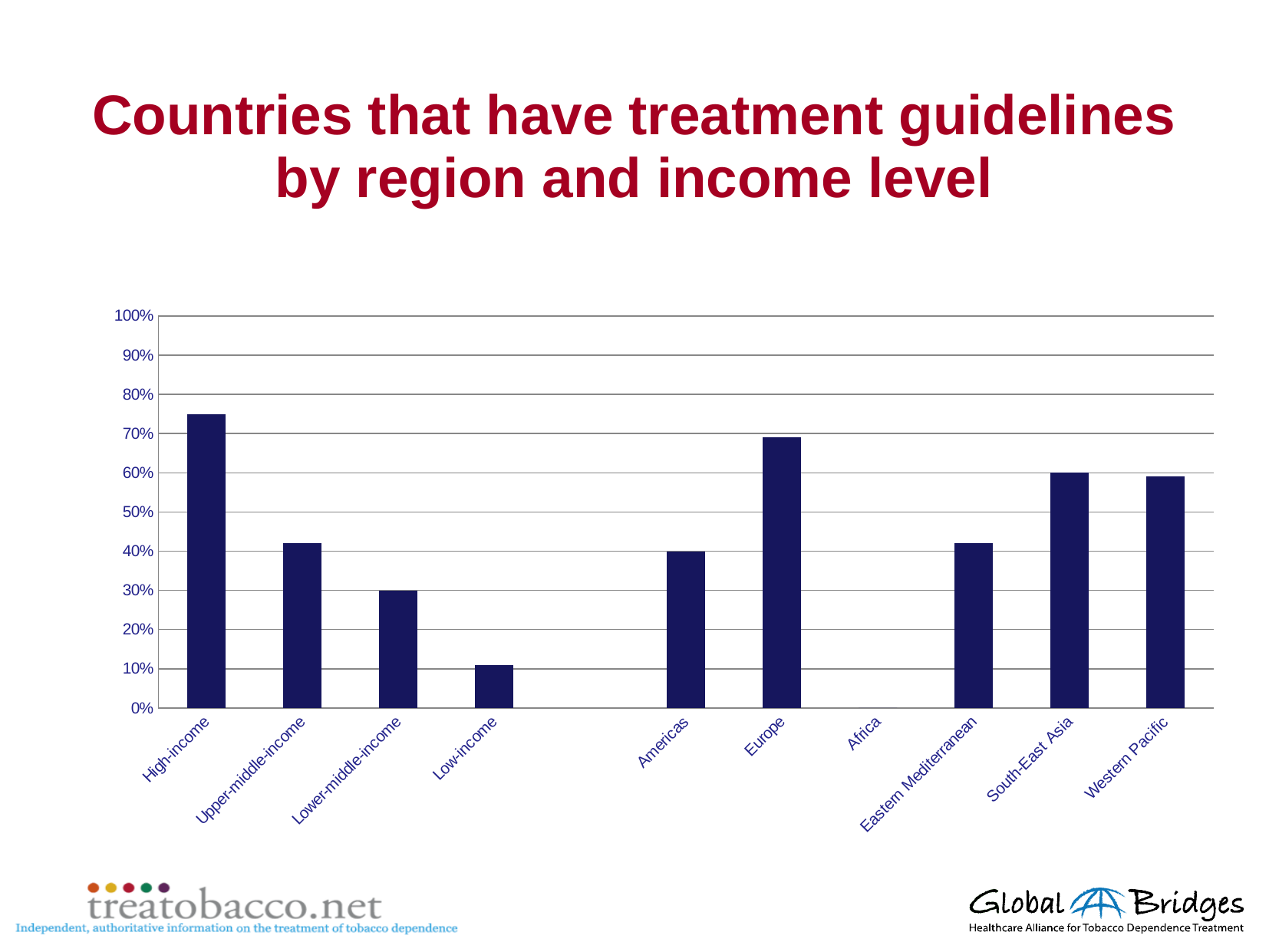
Which category has the lowest value? Africa What kind of chart is shown on the slide? bar chart Is the value for Europe greater or less than 60%? greater Is the value for Upper-middle-income greater or less than 50%? less Which is larger, the value for High-income or the value for Europe? High-income Which is larger, the value for Lower-middle-income or the value for Americas? Americas Is the value for Low-income greater or less than 20%? less How many categories are shown on the x axis? 10 Which category has the highest value? High-income Which is larger, the value for Europe or the value for Western Pacific? Europe What is the title of the chart? Countries that have treatment guidelines by region and income level